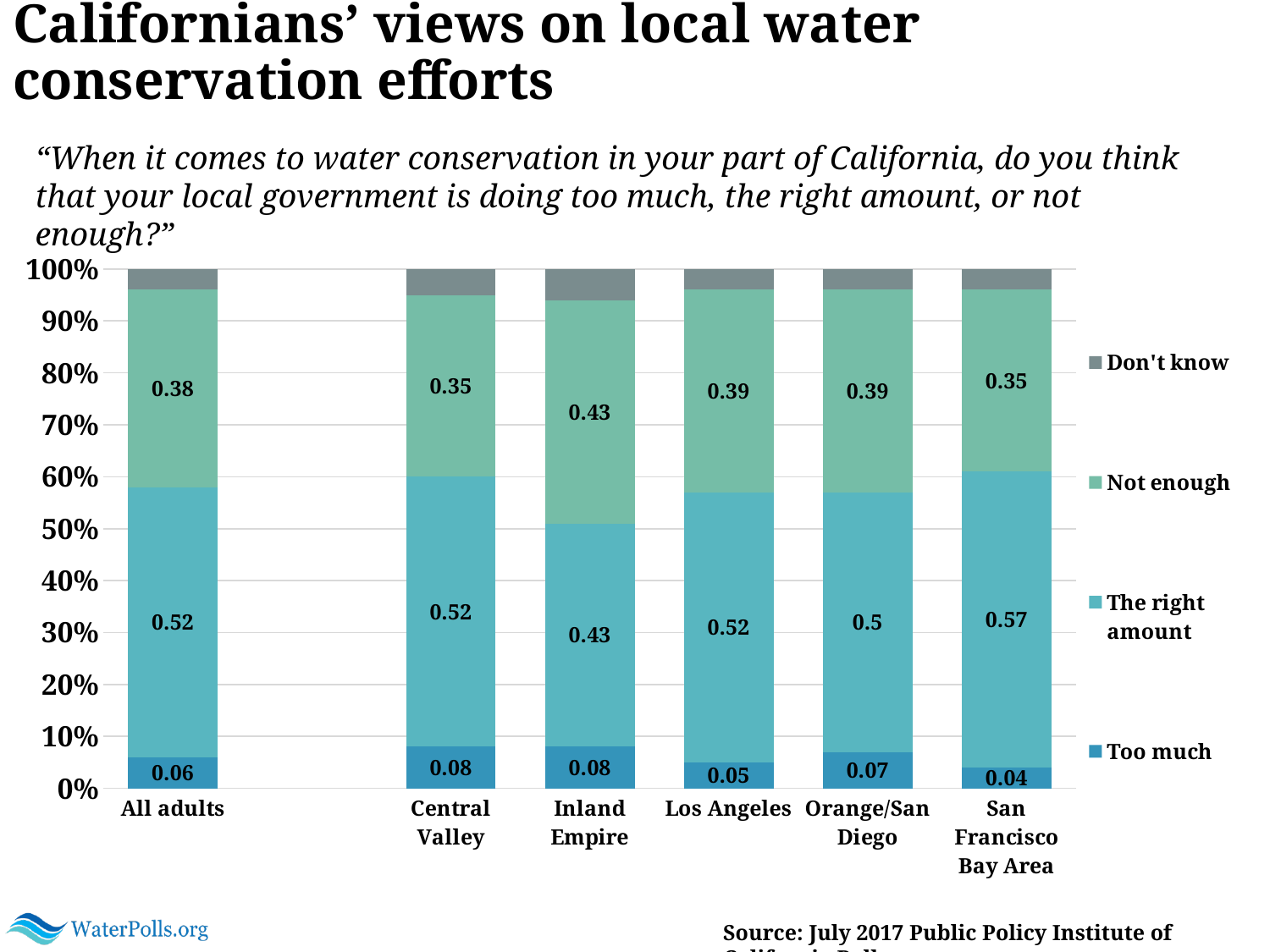
Which region has the highest value for "Not enough"? Inland Empire What is the value for "The right amount" in the San Francisco Bay Area? 0.57 Which region has the lowest value for "Too much"? San Francisco Bay Area What is the difference between the "Not enough" values for the Inland Empire and the Central Valley? 0.08 What is the value for "Not enough" in the Inland Empire? 0.43 Is the "Don't know" share for the Inland Empire greater or less than 10%? less Which region has the highest value for "The right amount"? San Francisco Bay Area How many series does the legend list? 4 Which is larger, the "The right amount" value for Los Angeles or for Orange/San Diego? Los Angeles What kind of chart is shown on the slide? Stacked bar chart What is the value for "Too much" in the Central Valley? 0.08 How many categories are shown on the x axis? 6